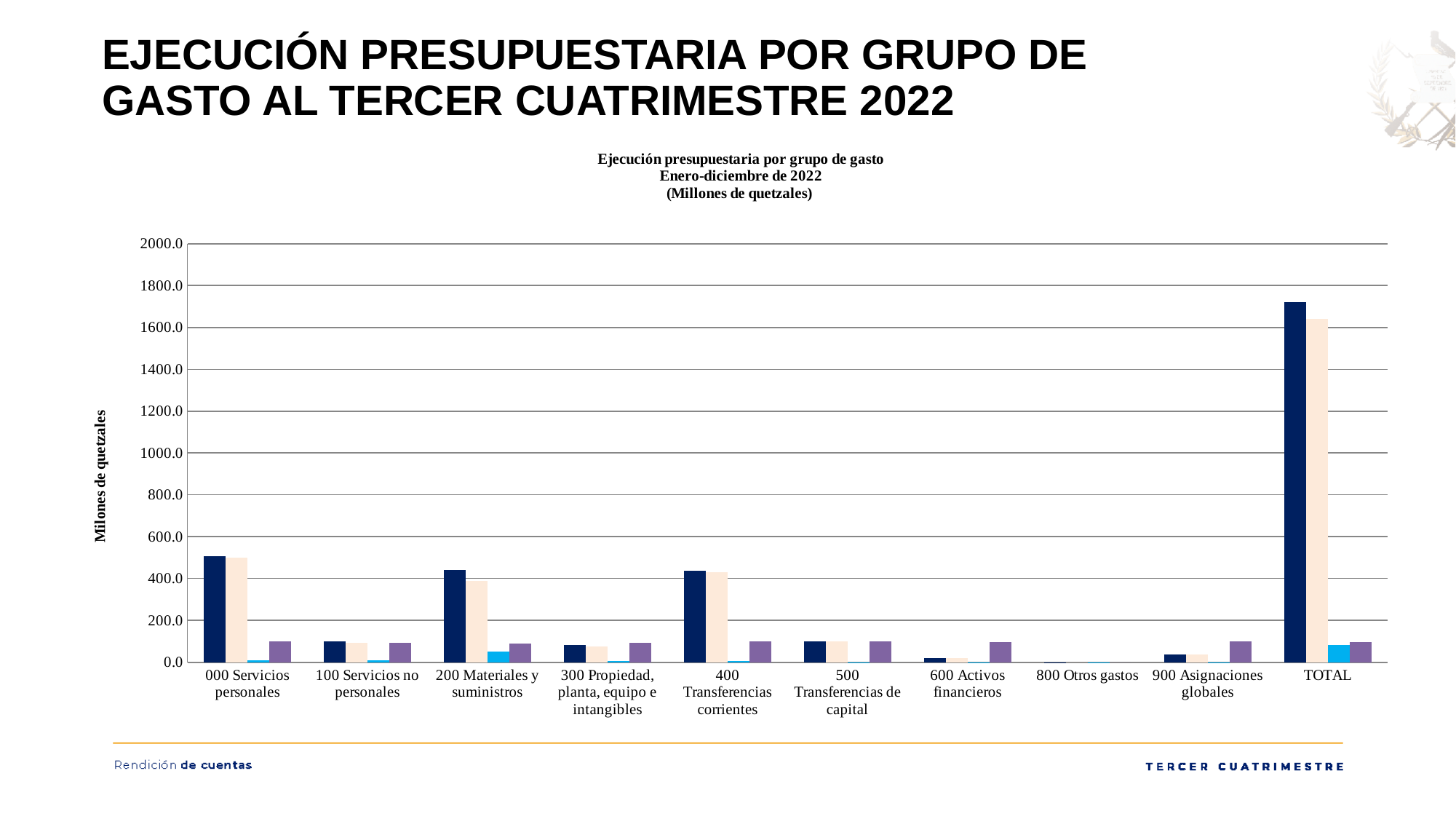
Is the value of the dark blue bar for TOTAL greater or less than 1600? greater How many categories are shown along the x axis of the chart? 10 Which has the taller dark blue bar: 000 Servicios personales or 200 Materiales y suministros? 000 Servicios personales Is the value of the dark blue bar for 600 Activos financieros greater or less than 200? less Is the value of the dark blue bar for 100 Servicios no personales greater or less than 200? less Which category has the tallest bar in the chart? TOTAL Excluding TOTAL, which category has the smallest dark blue bar? 800 Otros gastos What is the title of the vertical axis of the chart? Millones de quetzales What kind of chart is shown on the slide? bar chart What is the highest value shown on the vertical axis of the chart? 2000.0